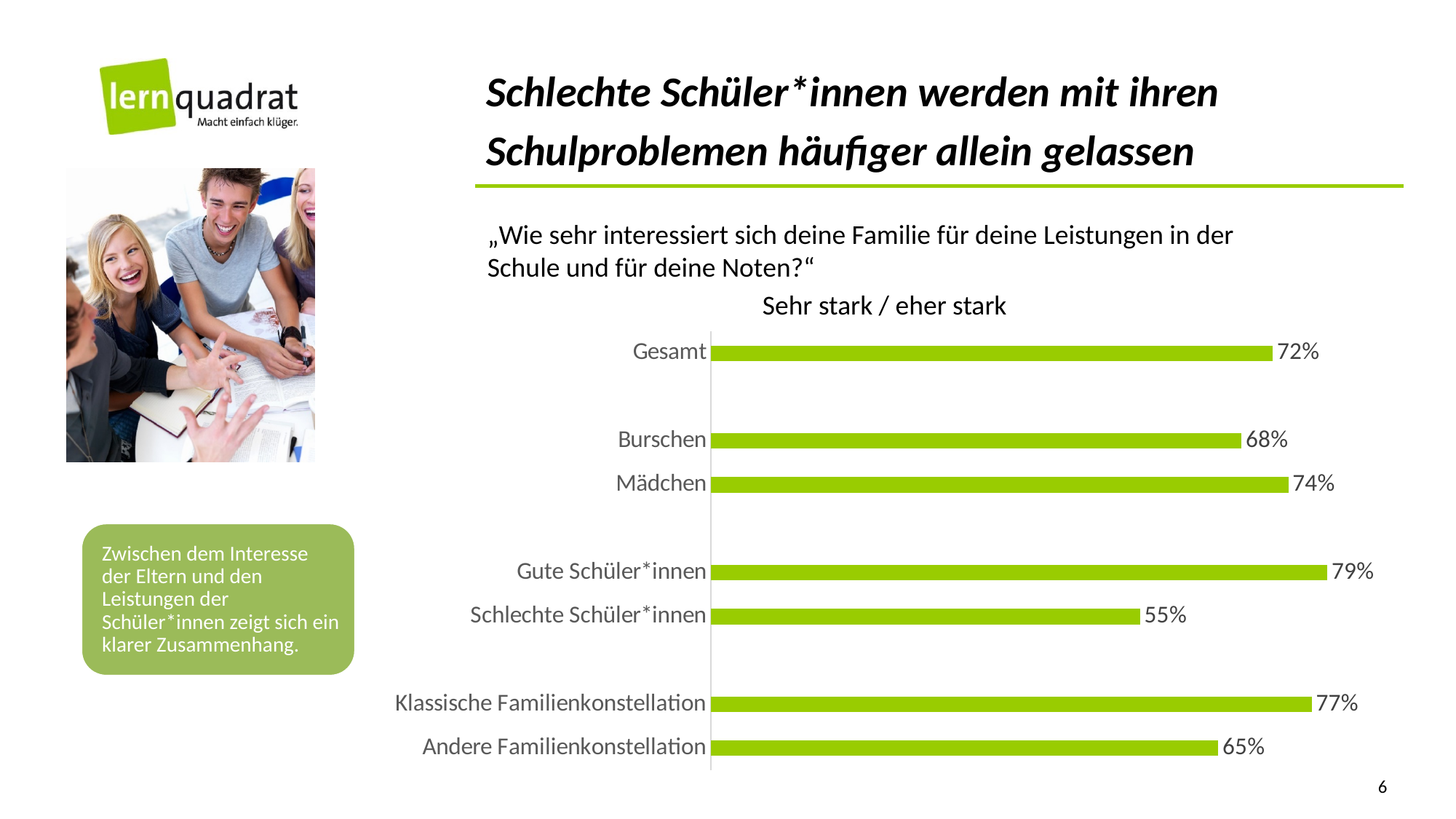
What is the value for Schlechte Schüler*innen? 55% What is the value for Gesamt? 72% Which is larger, Klassische Familienkonstellation or Andere Familienkonstellation? Klassische Familienkonstellation What is the difference between Gute Schüler*innen and Schlechte Schüler*innen? 24% How many categories are shown in the chart? 7 Which category has the lowest value? Schlechte Schüler*innen Which category has the highest value? Gute Schüler*innen What is the value for Mädchen? 74% What kind of chart is shown on the slide? Bar chart What is the title of the chart? Sehr stark / eher stark What is the difference between Mädchen and Burschen? 6% What is the value for Andere Familienkonstellation? 65%